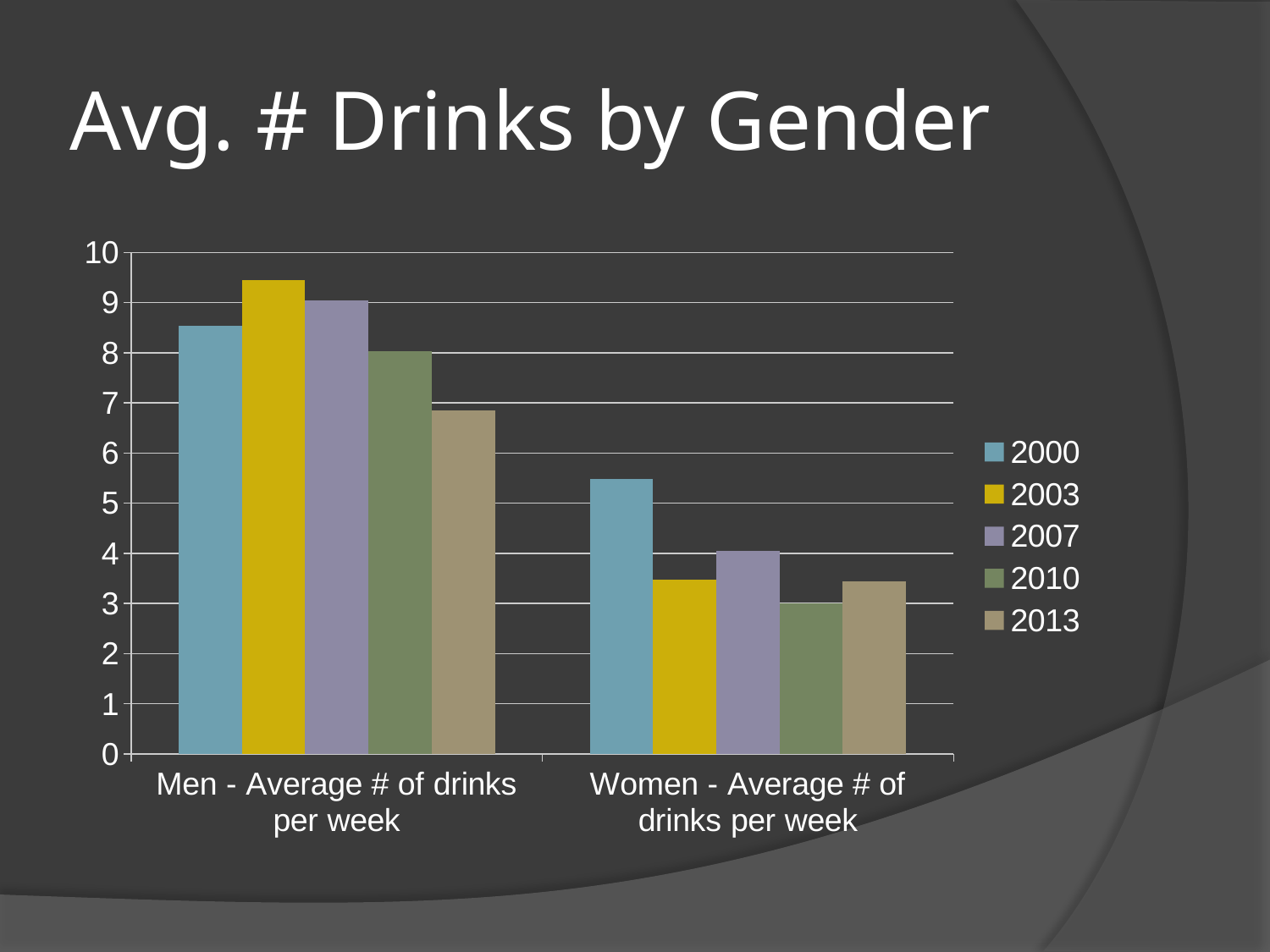
Which year has the highest value for Women - Average # of drinks per week? 2000 Is the value for Men in 2013 greater or less than 7? less Is the value for Women in 2000 greater or less than 5? greater What is the title of the slide? Avg. # Drinks by Gender For Women, which is larger: the value for 2007 or the value for 2003? 2007 Is the value for Men in 2003 greater or less than 9? greater Which year has the lowest value for Men - Average # of drinks per week? 2013 Which year has the lowest value for Women - Average # of drinks per week? 2010 Which year has the highest value for Men - Average # of drinks per week? 2003 How many categories are shown on the x axis? 2 What kind of chart is shown on the slide? bar chart How many series does the legend list? 5